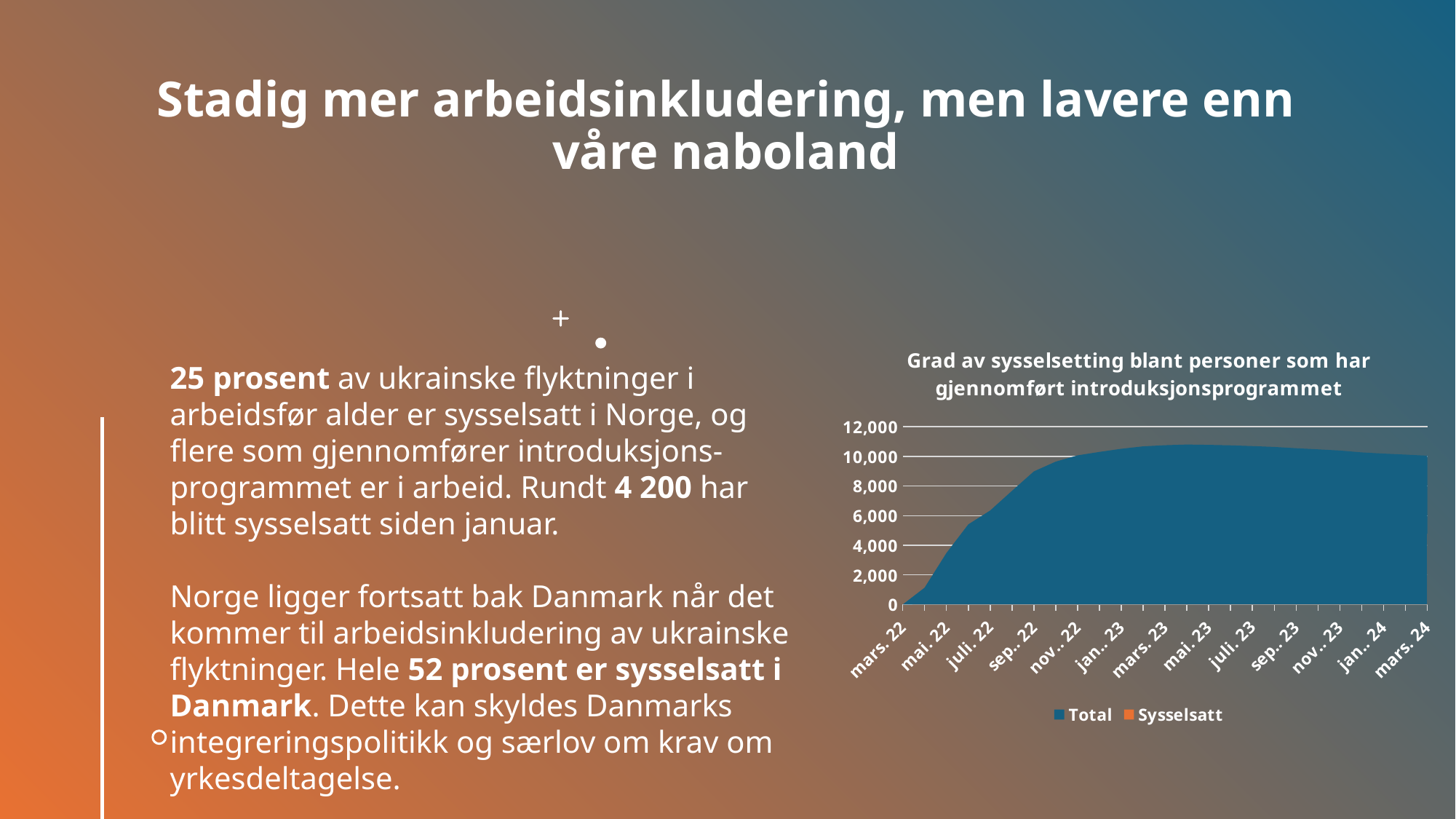
What is the title of the chart? Grad av sysselsetting blant personer som har gjennomført introduksjonsprogrammet What kind of chart is shown on the slide? Area chart Does the Total series rise or fall between mars. 22 and jan.. 23? rise Is the Total value for mars. 22 greater or less than 2,000? less How many series does the chart legend list? 2 Is the Total value for mai. 23 greater or less than 12,000? less How many month labels are shown along the x axis of the chart? 13 Is the Total value for juli. 22 greater or less than 4,000? greater What are the two series named in the chart legend? Total and Sysselsatt Which is larger, the Total value for mars. 22 or the Total value for mars. 23? mars. 23